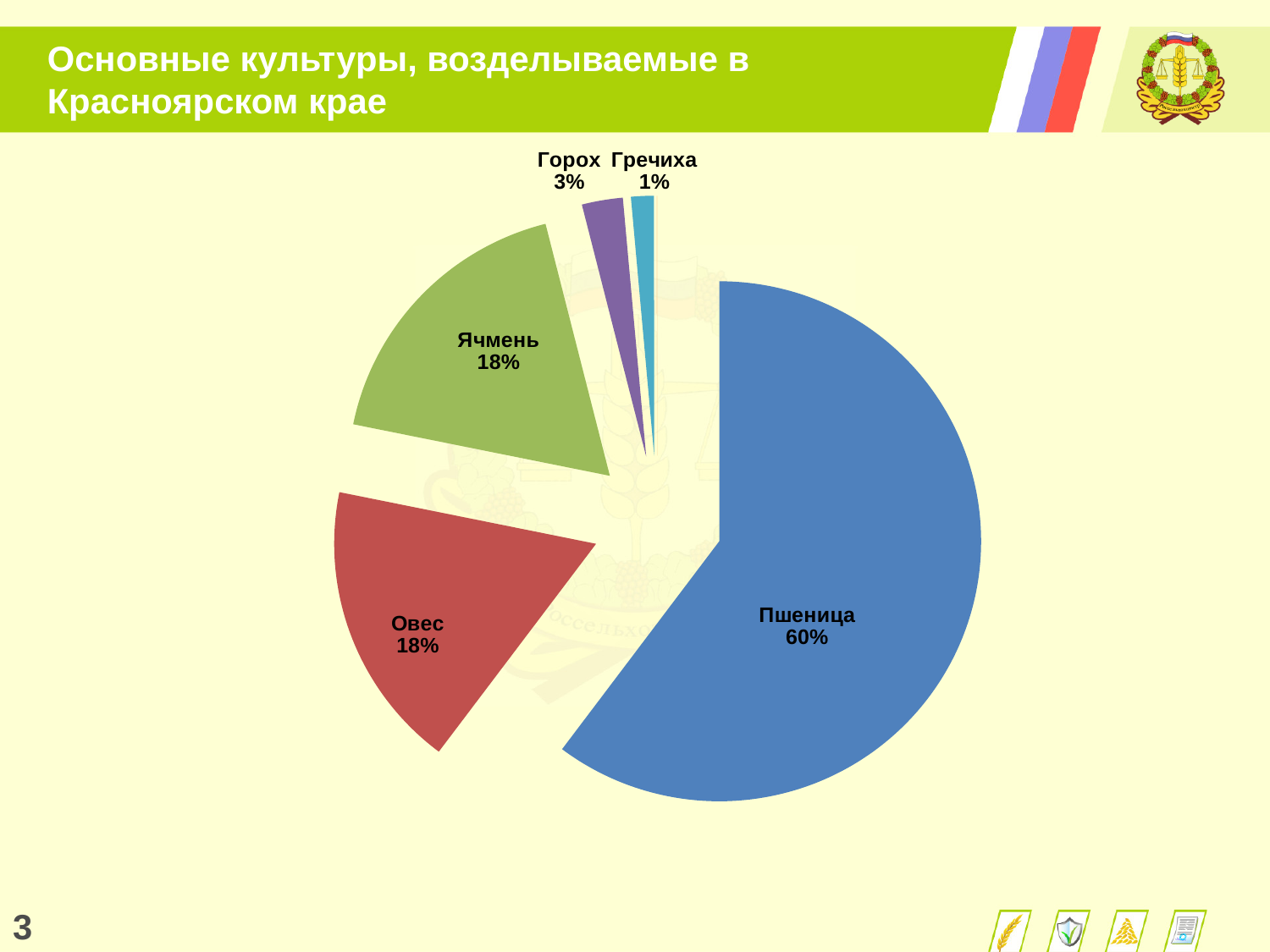
What share of the pie does Пшеница have? 60% Which is larger, the share of Горох or the share of Гречиха? Горох How many categories are shown in the pie chart? 5 What is the value shown for Ячмень? 18% Which category has the largest slice of the pie? Пшеница What kind of chart is shown on the slide? pie chart What is the value shown for Гречиха? 1% Which category has the smallest slice of the pie? Гречиха What is the value shown for Горох? 3% What is the difference between the shares of Горох and Гречиха? 2% What colour is the slice for Пшеница? blue What is the difference between the shares of Пшеница and Овес? 42%